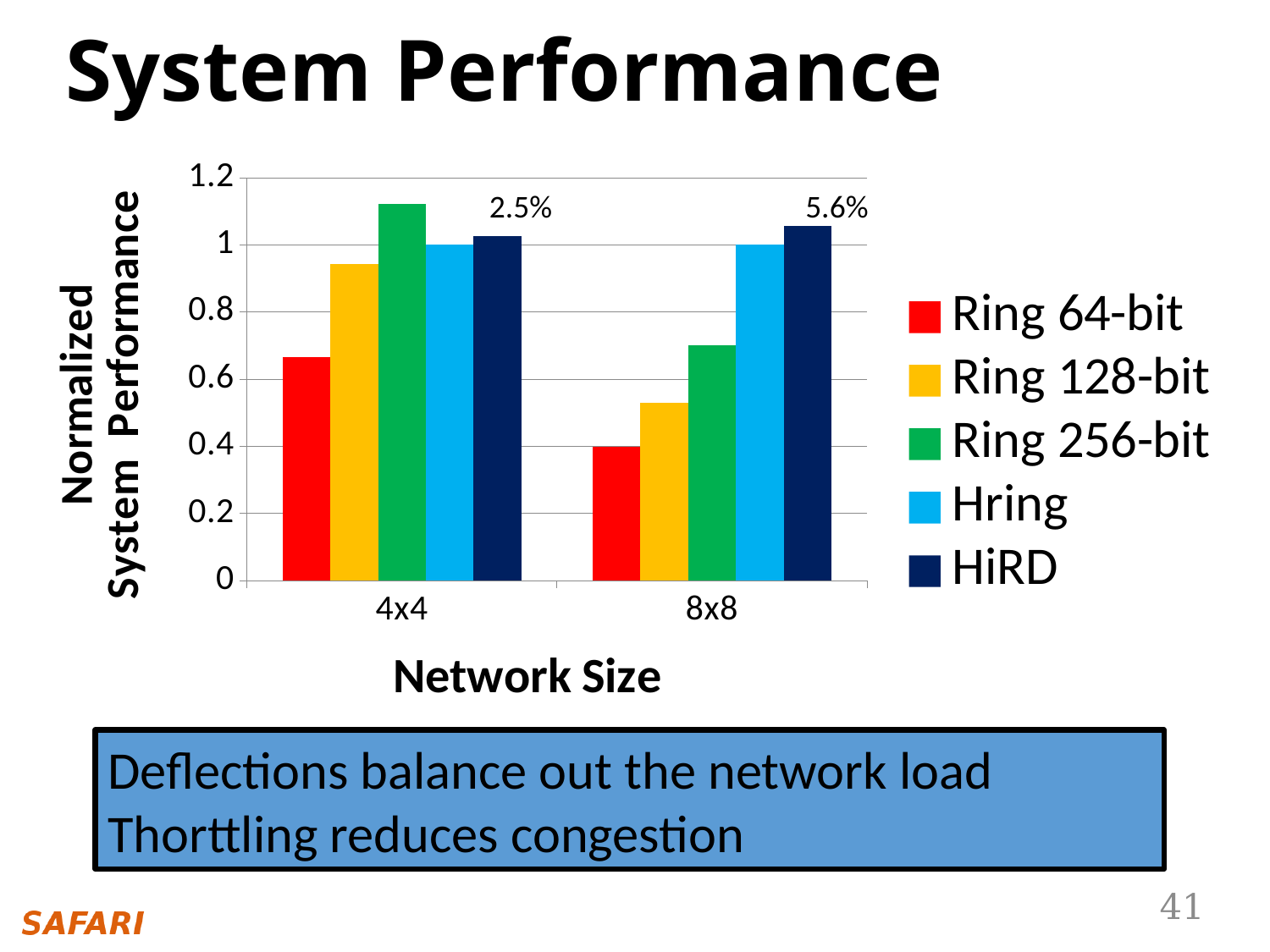
What kind of chart is shown on the slide? bar chart Is the normalized system performance of Ring 128-bit for 4x4 greater or less than 0.8? greater Does the normalized system performance of Ring 64-bit rise or fall from 4x4 to 8x8? fall Which series has the highest normalized system performance for the 4x4 network size? Ring 256-bit Which series has the lowest normalized system performance for the 8x8 network size? Ring 64-bit Which is larger for Ring 256-bit: the value at 4x4 or the value at 8x8? 4x4 Is the normalized system performance of Ring 64-bit for 8x8 greater or less than 0.6? less Which series has the lowest normalized system performance for the 4x4 network size? Ring 64-bit How many series does the legend list? 5 What is the normalized system performance of Hring for the 4x4 network size? 1 How many network sizes are shown on the x axis? 2 What percentage label is printed above the HiRD bar for the 8x8 network size? 5.6%